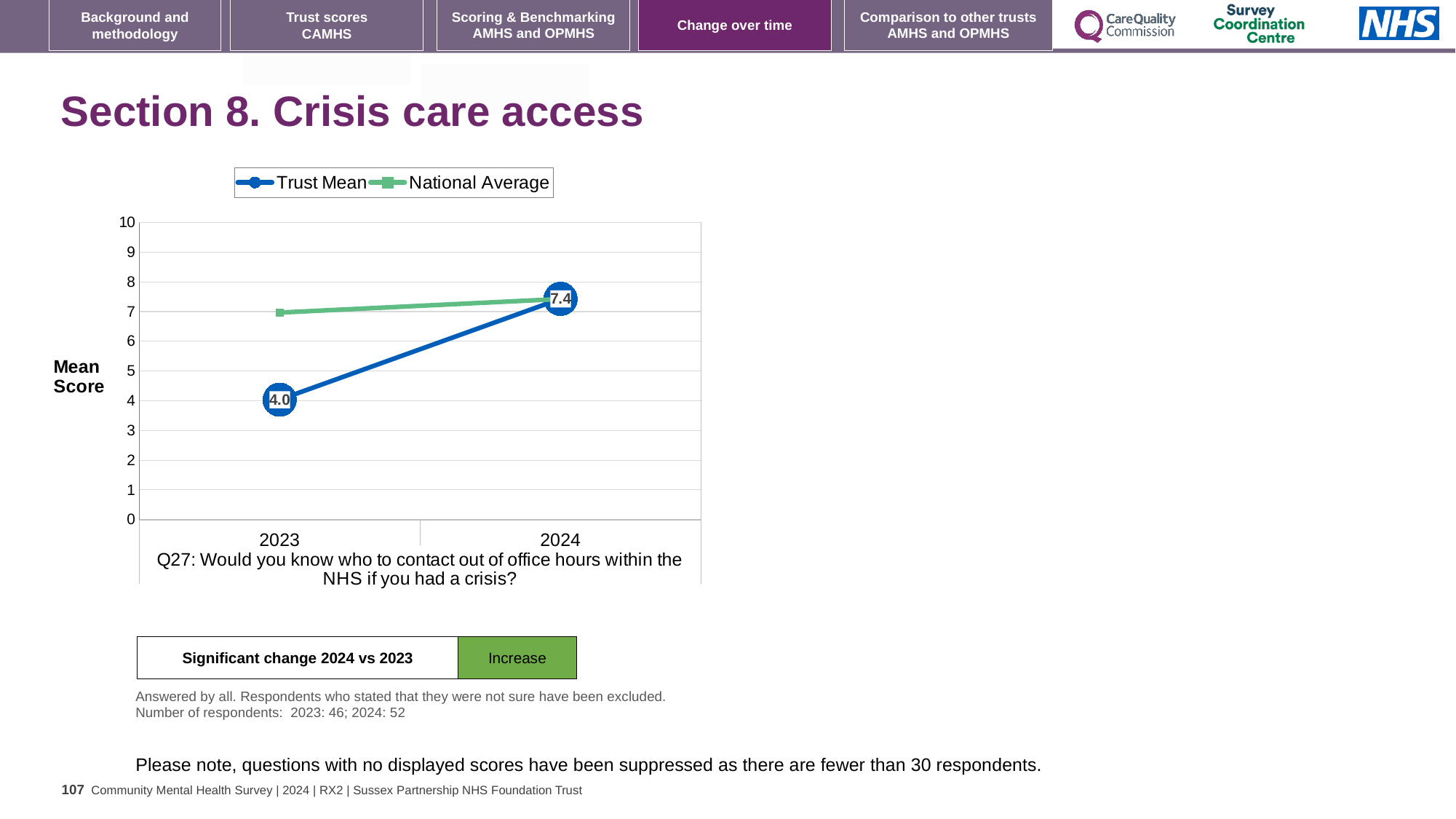
Is the National Average value for 2023 greater or less than 8? less How many series does the legend list? 2 What kind of chart is shown on the slide? line chart In which year is the Trust Mean higher? 2024 How many years are plotted on the x axis? 2 What is the Trust Mean score for 2024? 7.4 In 2023, which is larger: the Trust Mean or the National Average? National Average What is the Trust Mean score for 2023? 4.0 Is the National Average value for 2023 greater or less than 5? greater By how much did the Trust Mean score change from 2023 to 2024? 3.4 What is the label on the y axis of the chart? Mean Score Does the Trust Mean rise or fall from 2023 to 2024? rise